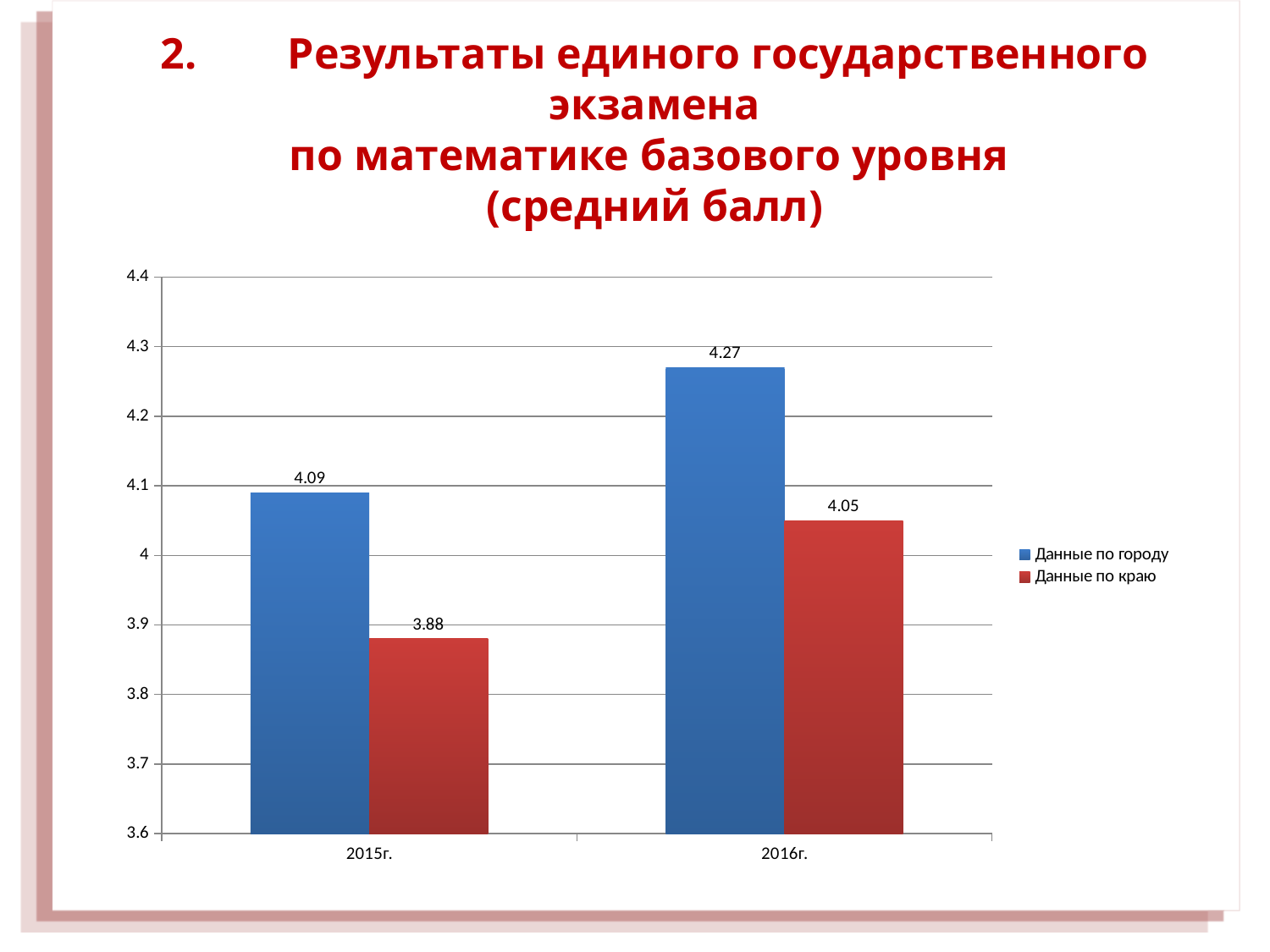
What is the value for Данные по краю in 2015г.? 3.88 What kind of chart is shown on the slide? Bar chart Is the value for Данные по городу in 2016г. greater or less than 4.2? greater Which is larger in 2015г.: Данные по городу or Данные по краю? Данные по городу What is the value for Данные по городу in 2015г.? 4.09 What is the difference between Данные по городу and Данные по краю in 2016г.? 0.22 Which bar has the lowest value on the chart? Данные по краю, 2015г. How many categories are shown on the x axis? 2 What is the difference between the 2016г. and 2015г. values for Данные по краю? 0.17 How many series does the legend list? 2 What is the value for Данные по краю in 2016г.? 4.05 Which year has the highest value for Данные по городу? 2016г.